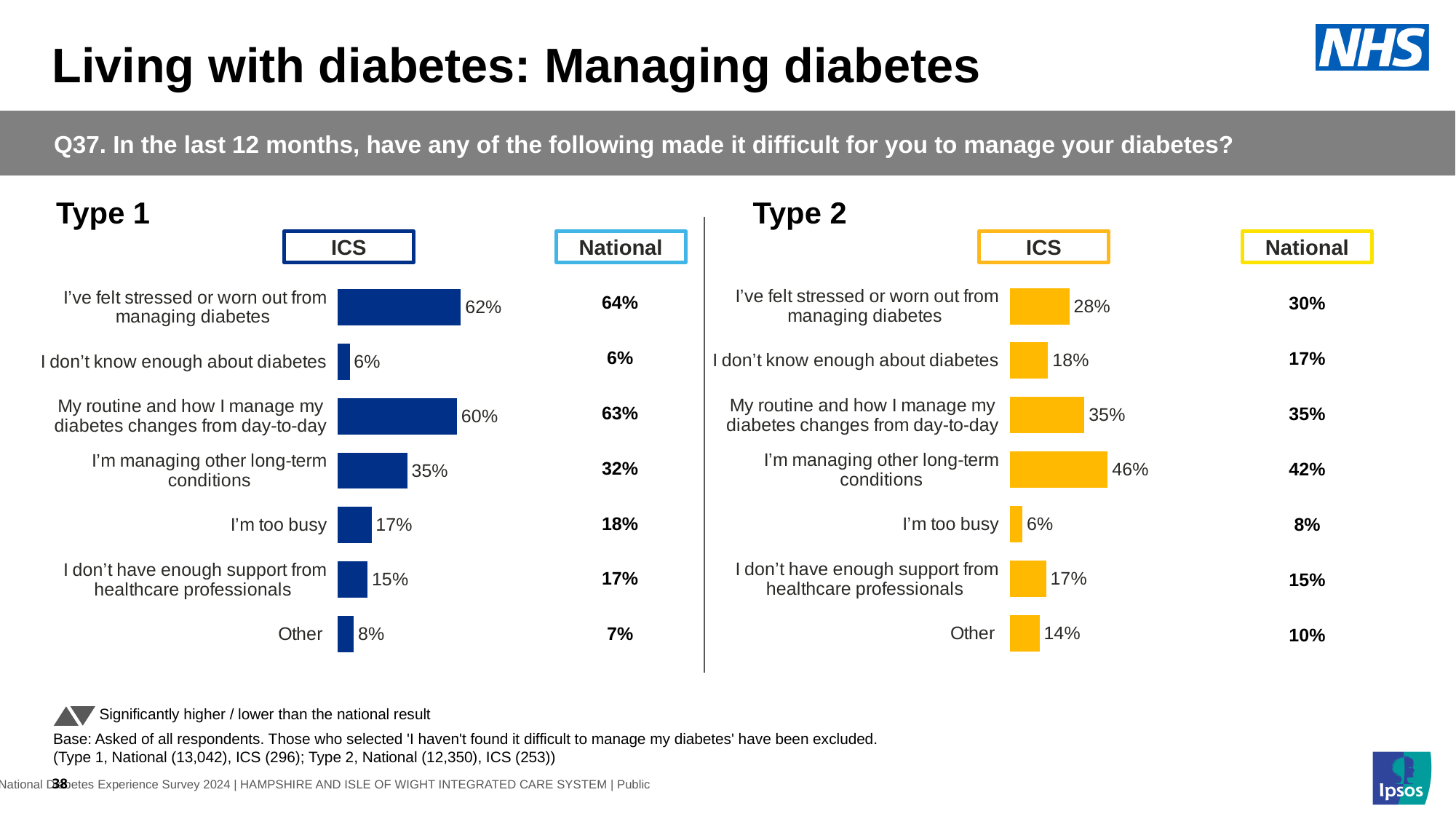
In the Type 1 chart, which category has the highest ICS value? I've felt stressed or worn out from managing diabetes How many categories are shown in the Type 1 chart? 7 In the Type 1 chart, what is the difference between the ICS and National values for 'I'm managing other long-term conditions'? 3 percentage points In the Type 1 chart, which is larger for 'I'm too busy': the ICS value or the National value? National In the Type 2 chart, which category has the lowest ICS value? I'm too busy In the Type 2 chart, what is the National value for 'I don't know enough about diabetes'? 17% In the Type 2 chart, what is the ICS value for 'I'm managing other long-term conditions'? 46% In the Type 2 chart, what is the difference between the ICS values for 'I'm managing other long-term conditions' and 'My routine and how I manage my diabetes changes from day-to-day'? 11 percentage points In the Type 1 chart, what is the ICS value for 'I've felt stressed or worn out from managing diabetes'? 62% What type of chart is used for the Type 2 ICS results? Bar chart In the Type 2 chart, which is larger for 'Other': the ICS value or the National value? ICS What colour are the ICS bars in the Type 2 chart? Yellow/orange